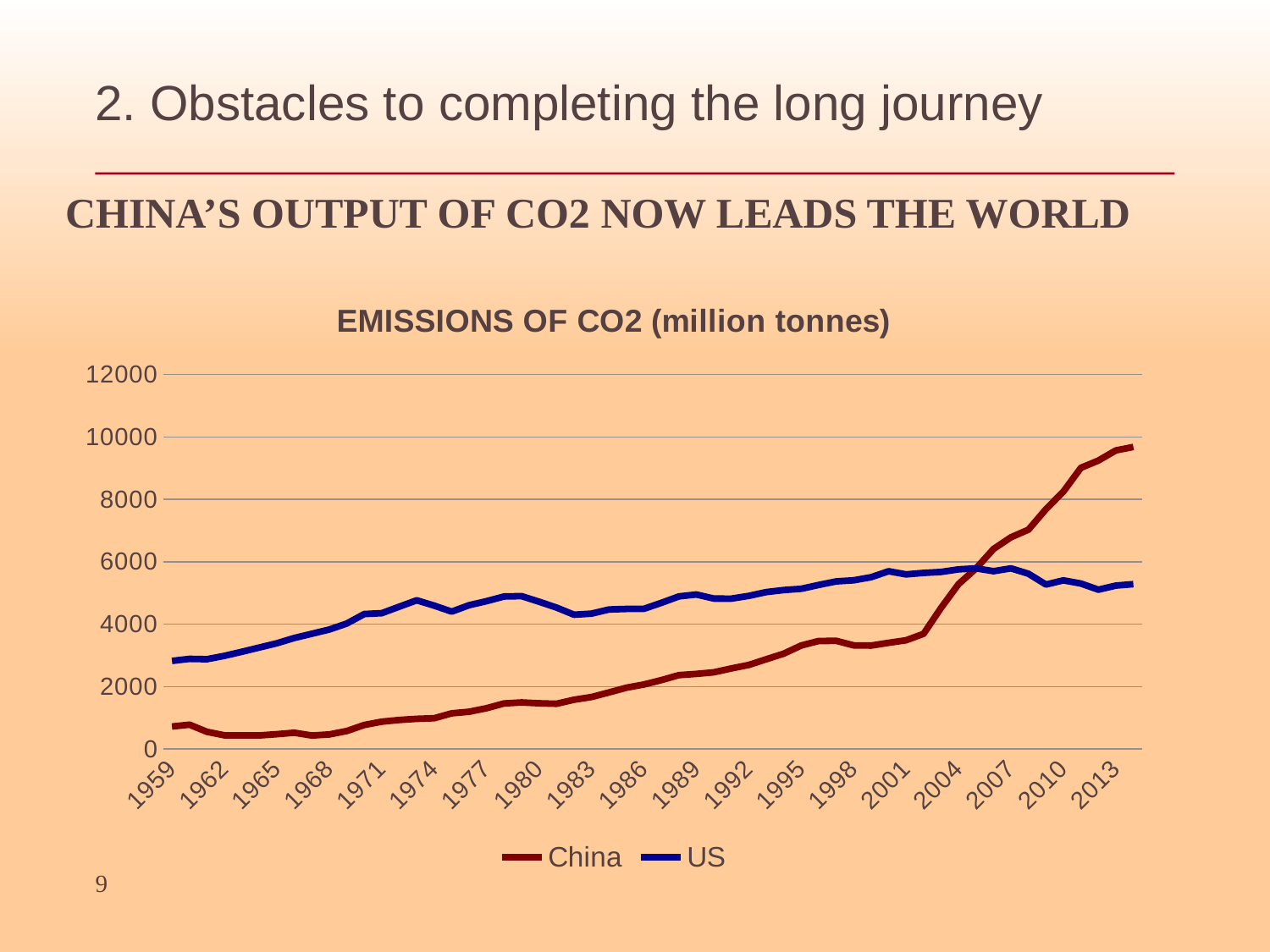
Is the value for China in 2013 greater or less than 8000? greater Which colour is used for the US line? blue Is the value for the US in 2013 greater or less than 6000? less Does the China line generally rise or fall from 1959 to 2013? rise What is the title of the chart? EMISSIONS OF CO2 (million tonnes) What kind of chart is shown on the slide? line chart Is the value for the US in 1959 greater or less than 2000? greater In 1989, which series has the higher value, China or the US? US How many series does the legend list? 2 In 2013, which series has the higher value, China or the US? China